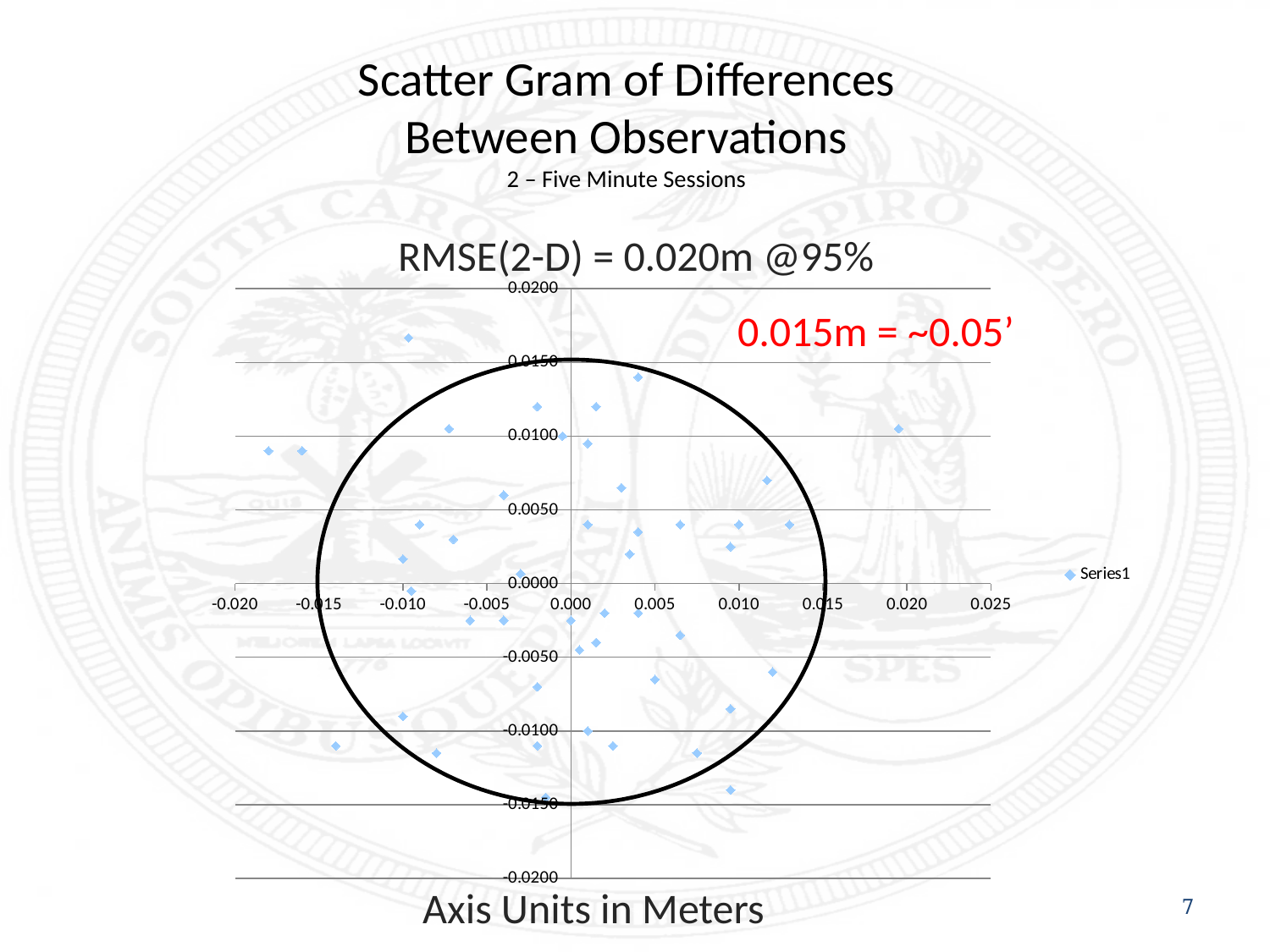
What is the name of the series shown in the legend? Series1 Is the x value of the rightmost plotted point greater or less than 0.020? less What is the title of the chart on the slide? Scatter Gram of Differences Between Observations Is the x value of the leftmost plotted point greater or less than -0.015? less What kind of chart is shown on the slide? scatter chart Is the y value of the highest plotted point greater or less than 0.0150? greater How many series does the legend list? 1